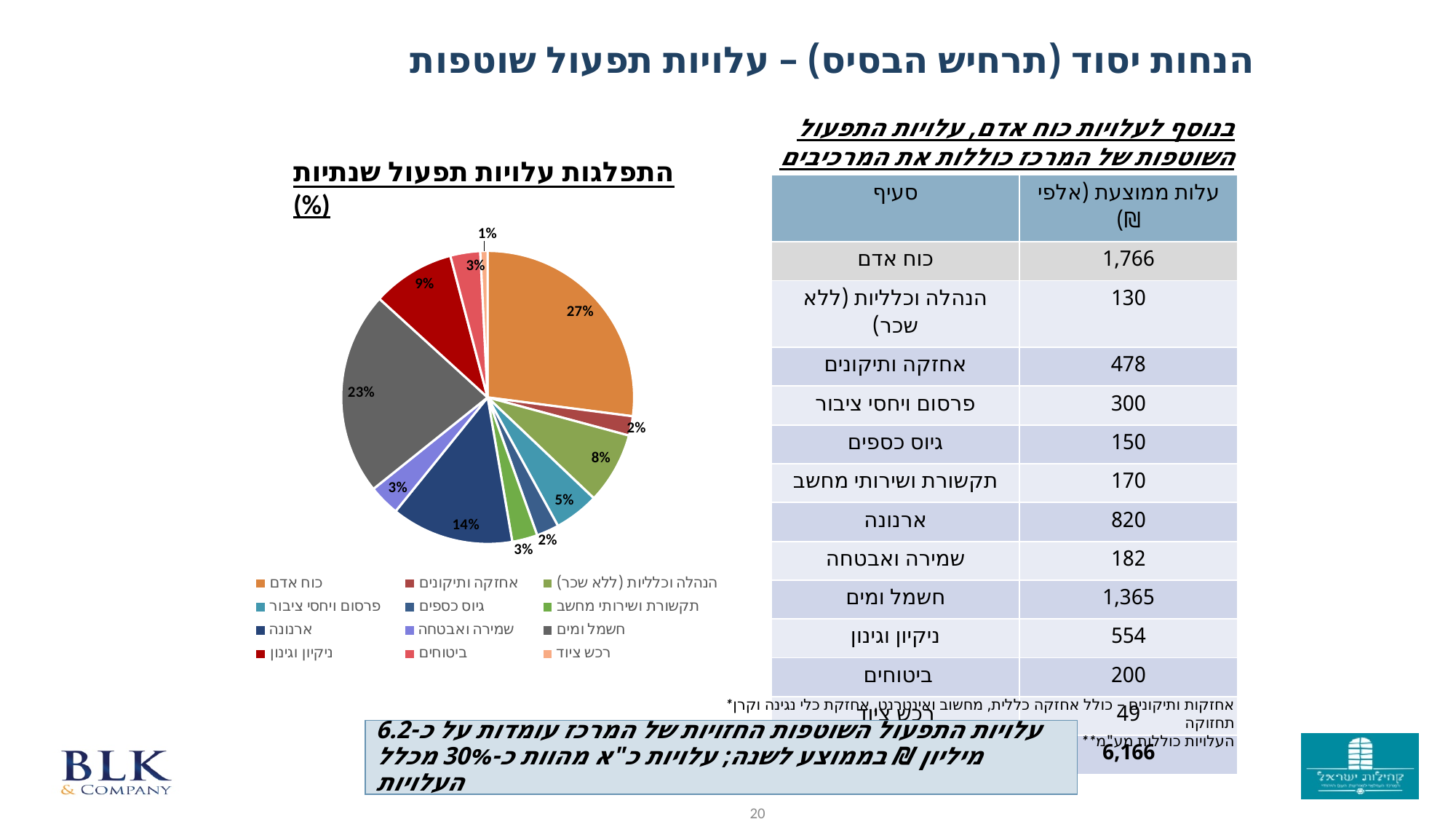
What is the value shown for ניקיון וגינון? 9% What share of the pie does כוח אדם represent? 27% What is the value shown for ארנונה? 14% Which category has the smallest slice of the pie? רכש ציוד What is the chart's title? התפלגות עלויות תפעול שנתיות (%) What kind of chart is shown on the slide? pie chart Which is larger, the slice for חשמל ומים or the slice for ארנונה? חשמל ומים Which category has the largest slice of the pie? כוח אדם What is the difference in percentage points between כוח אדם and חשמל ומים? 4 What is the value shown for רכש ציוד? 1% How many slices does the pie chart have? 12 What is the value shown for חשמל ומים? 23%